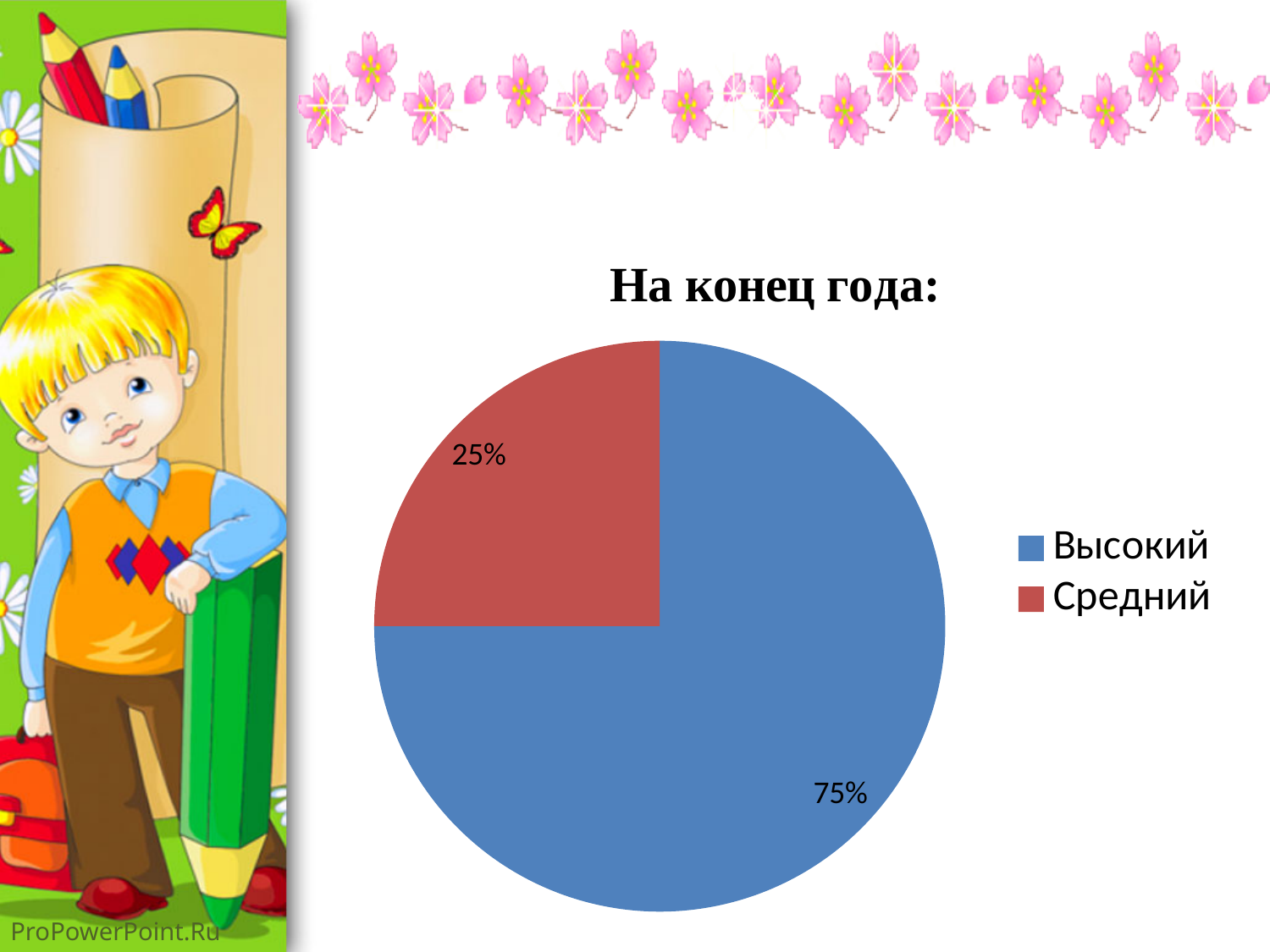
What is the total of the two slices shown? 100% Which category has the largest slice of the pie? Высокий What is the difference in percentage points between Высокий and Средний? 50 How many entries does the legend list? 2 What colour is the slice for Средний? red Which is larger, the slice for Высокий or the slice for Средний? Высокий What kind of chart is shown on the slide? pie chart What share of the pie does Средний take? 25% Which category has the smallest slice of the pie? Средний What is the title of the chart? На конец года: How many slices does the pie chart have? 2 What share of the pie does Высокий take? 75%